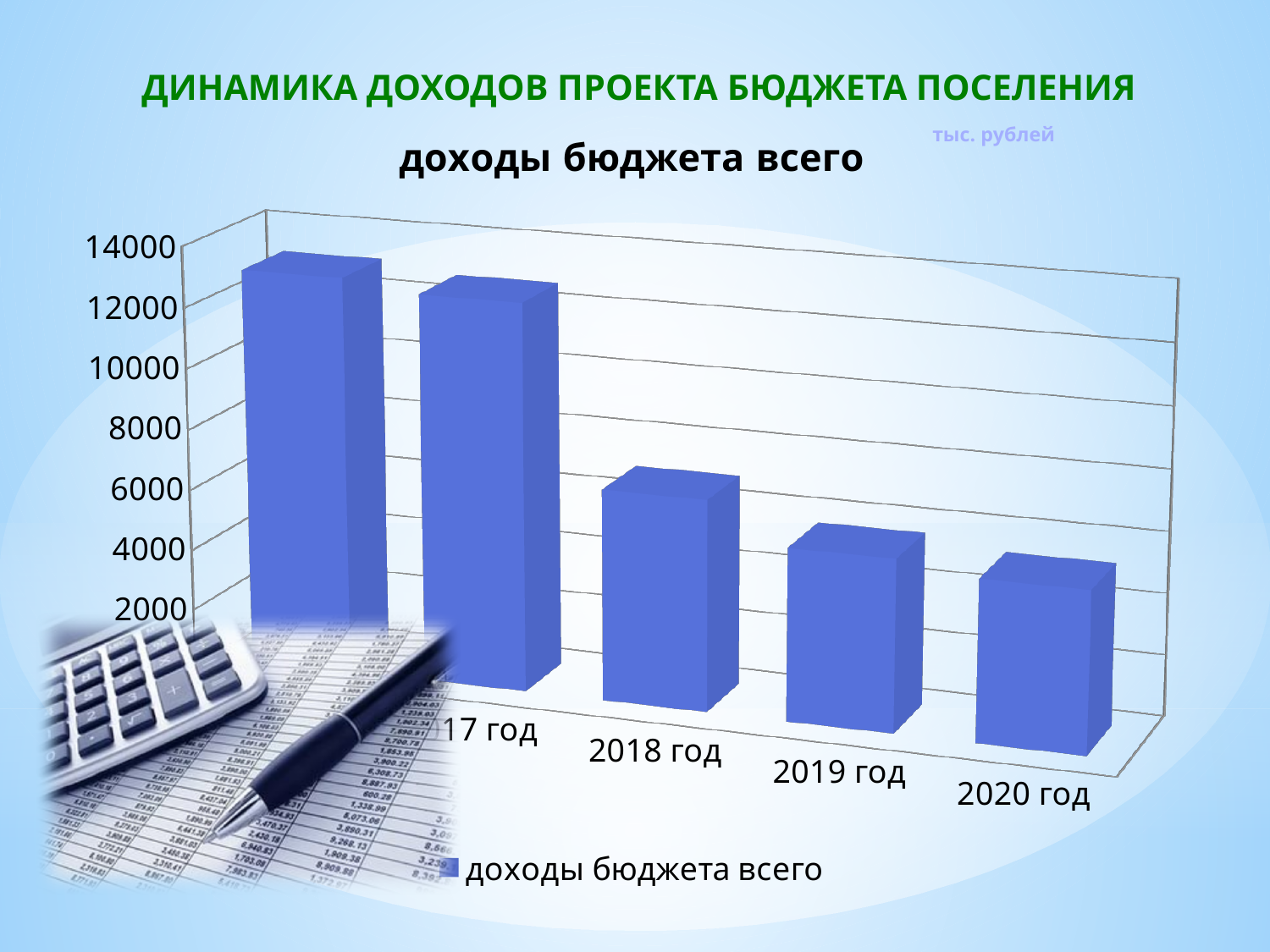
In what units are the chart values given, according to the slide? тыс. рублей Which labelled year has the lowest value in the chart? 2020 год Is the value for 2018 год greater or less than 8000? less Is the value for 2020 год greater or less than 6000? less What kind of chart is shown on the slide? bar chart Do the values rise or fall from left to right along the x axis? fall What is the title of the chart? доходы бюджета всего How many bars (categories) does the chart show? 5 Is the value for 2018 год greater or less than 4000? greater How many series does the legend list? 1 Which is larger, the value for 2019 год or the value for 2020 год? 2019 год Which is larger, the value for 2018 год or the value for 2019 год? 2018 год